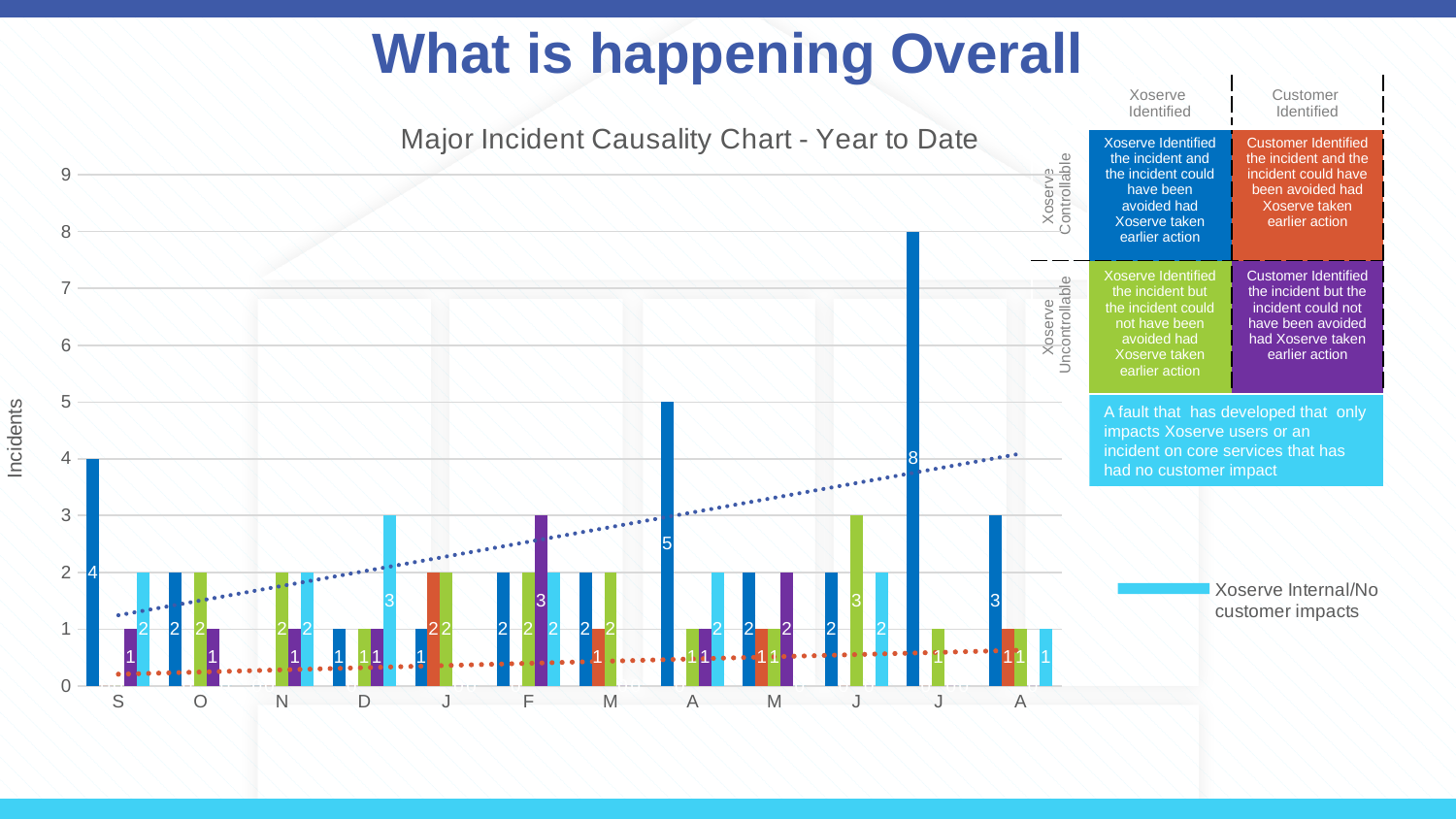
What kind of chart is the Major Incident Causality Chart? bar chart What is the title of the chart on the slide? Major Incident Causality Chart - Year to Date What is the difference between the tallest dark blue bar (8) and the dark blue bar for the first A (5) in the Major Incident Causality Chart? 3 What is the value of the purple bar for F in the Major Incident Causality Chart? 3 What is the value of the dark blue bar for the first A in the Major Incident Causality Chart? 5 What is the value of the light blue bar for D in the Major Incident Causality Chart? 3 What is the highest value labelled on any bar in the Major Incident Causality Chart? 8 Which month label has the tallest bar in the Major Incident Causality Chart? the third J How many month labels are shown on the x axis of the Major Incident Causality Chart? 12 What is the value of the dark blue bar for S in the Major Incident Causality Chart? 4 Which series does the light blue colour represent according to the legend on the slide? Xoserve Internal/No customer impacts Which is larger in the Major Incident Causality Chart: the dark blue bar for S or the dark blue bar for the first A? the dark blue bar for the first A